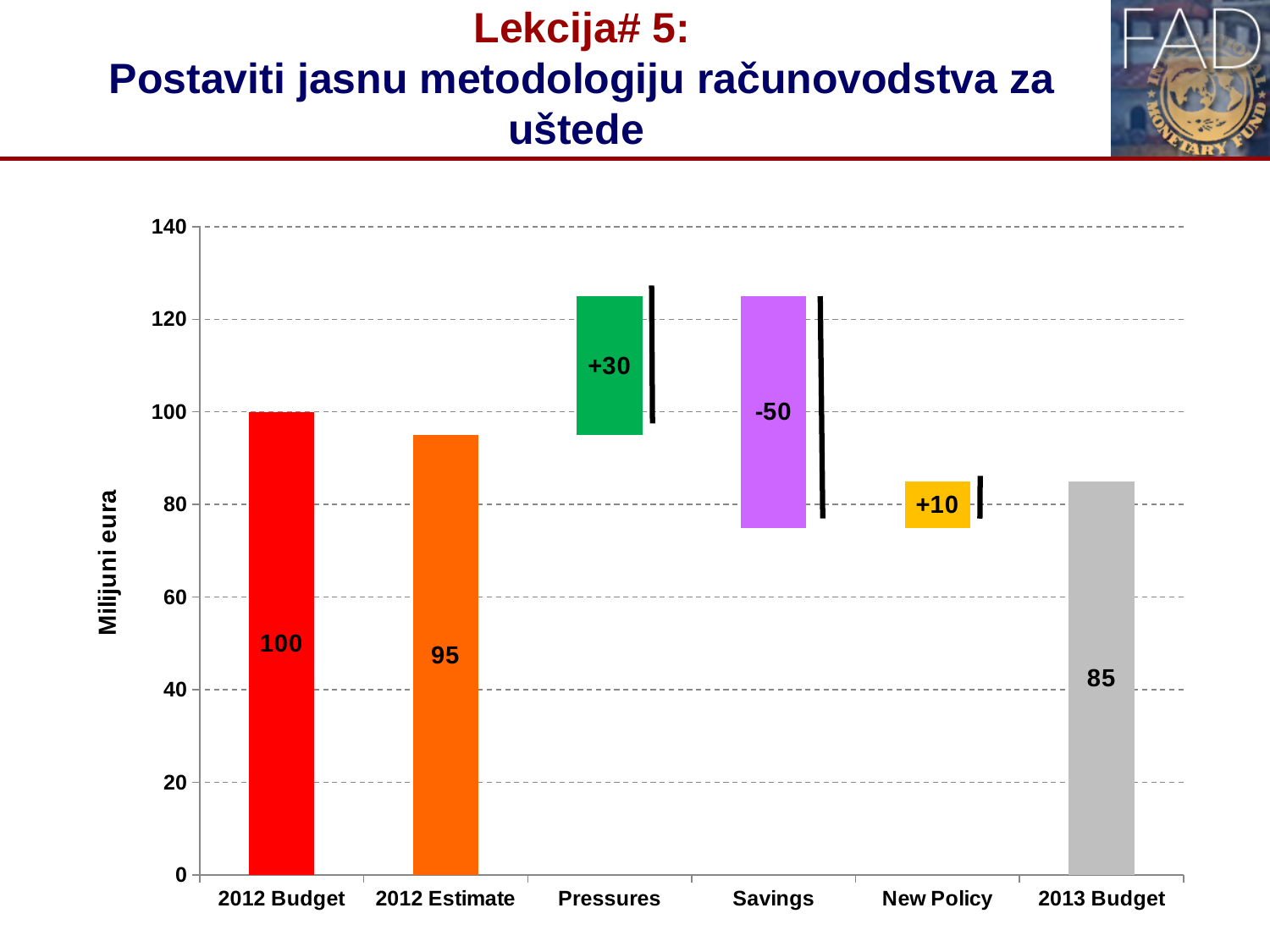
What value is labeled on the 2012 Budget bar? 100 What value is labeled on the 2013 Budget bar? 85 Which is larger, the 2012 Budget value or the 2012 Estimate value? 2012 Budget What value is labeled on the New Policy bar? +10 What value is labeled on the 2012 Estimate bar? 95 What value is labeled on the Savings bar? -50 What is the difference between the 2012 Budget value and the 2013 Budget value? 15 How many categories are shown on the x axis? 6 What value is labeled on the Pressures bar? +30 What kind of chart is shown on the slide? Bar chart Which category has the lowest labeled value? Savings What is the label of the vertical axis? Milijuni eura